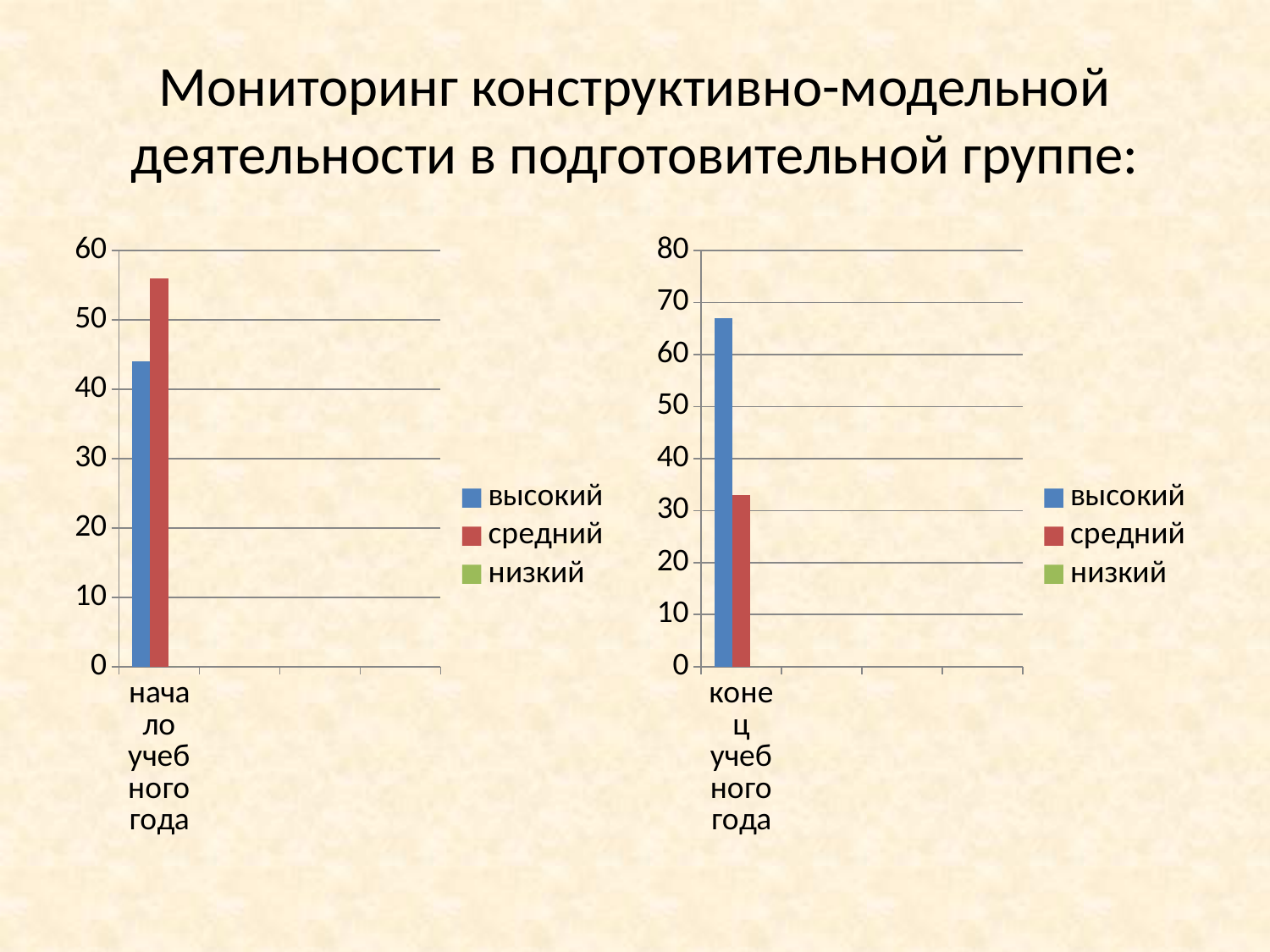
In the right chart (конец учебного года), which series has the highest bar? высокий How many series does the legend of the right chart (конец учебного года) list? 3 In the left chart (начало учебного года), is the value for средний greater or less than 60? less In the left chart (начало учебного года), which series has the higher bar, высокий or средний? средний In the right chart (конец учебного года), is the value for высокий greater or less than 60? greater In the right chart (конец учебного года), is the value for высокий greater or less than 70? less What colour represents the series средний in the legend of the left chart? red What is the category label on the x axis of the right chart? конец учебного года What kind of chart is the left chart (начало учебного года)? bar chart